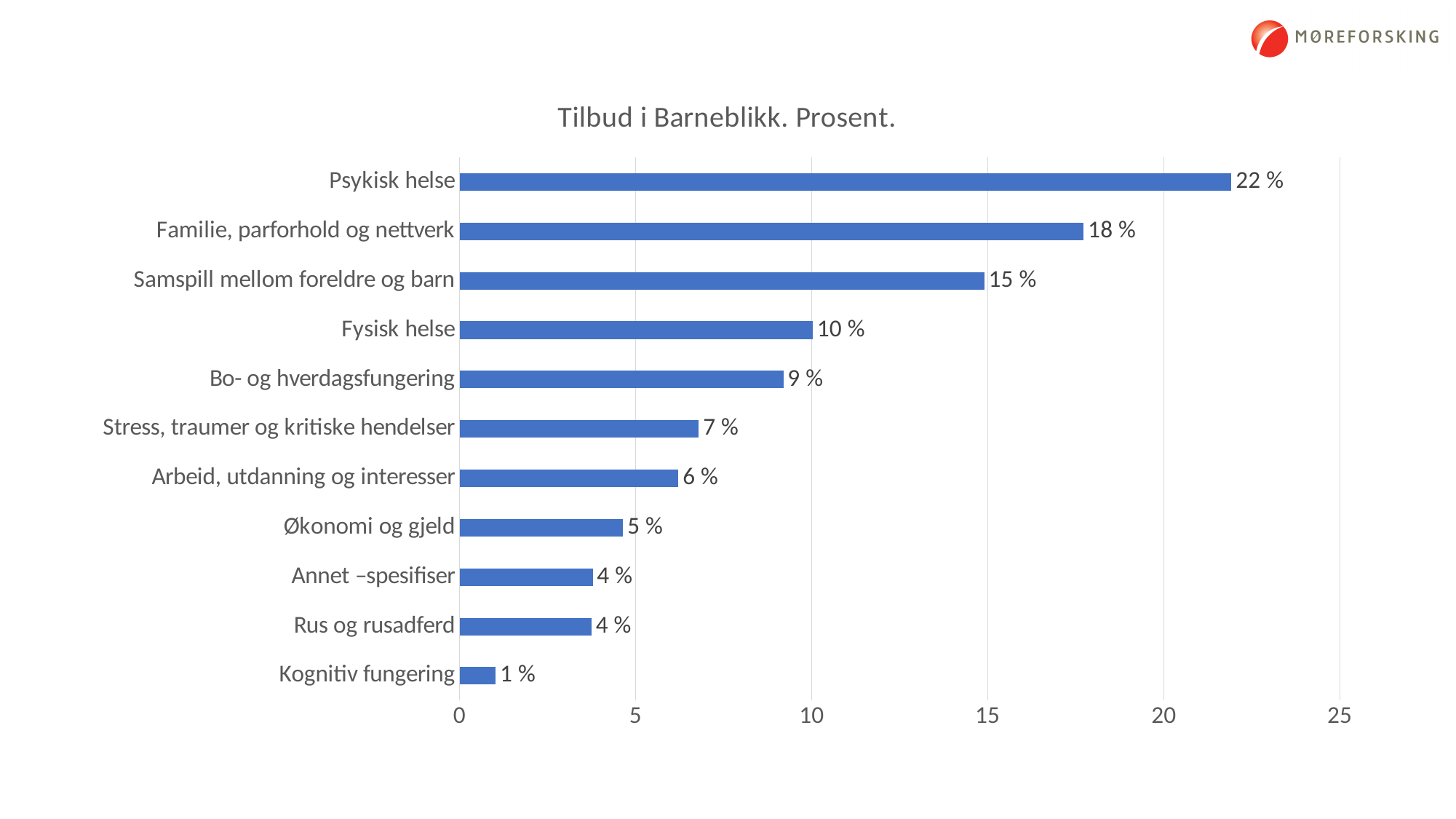
Is the value for Stress, traumer og kritiske hendelser greater or less than 10? less Which is larger, the value for Fysisk helse or the value for Bo- og hverdagsfungering? Fysisk helse What is the value for Psykisk helse? 22 % How many categories are shown in the chart? 11 Which category has the lowest value? Kognitiv fungering What is the value for Samspill mellom foreldre og barn? 15 % What kind of chart is shown on the slide? bar chart What is the difference between the values for Psykisk helse and Familie, parforhold og nettverk? 4 % Which category has the highest value? Psykisk helse What is the title of the chart? Tilbud i Barneblikk. Prosent. What is the difference between the values for Arbeid, utdanning og interesser and Kognitiv fungering? 5 % What is the value for Økonomi og gjeld? 5 %